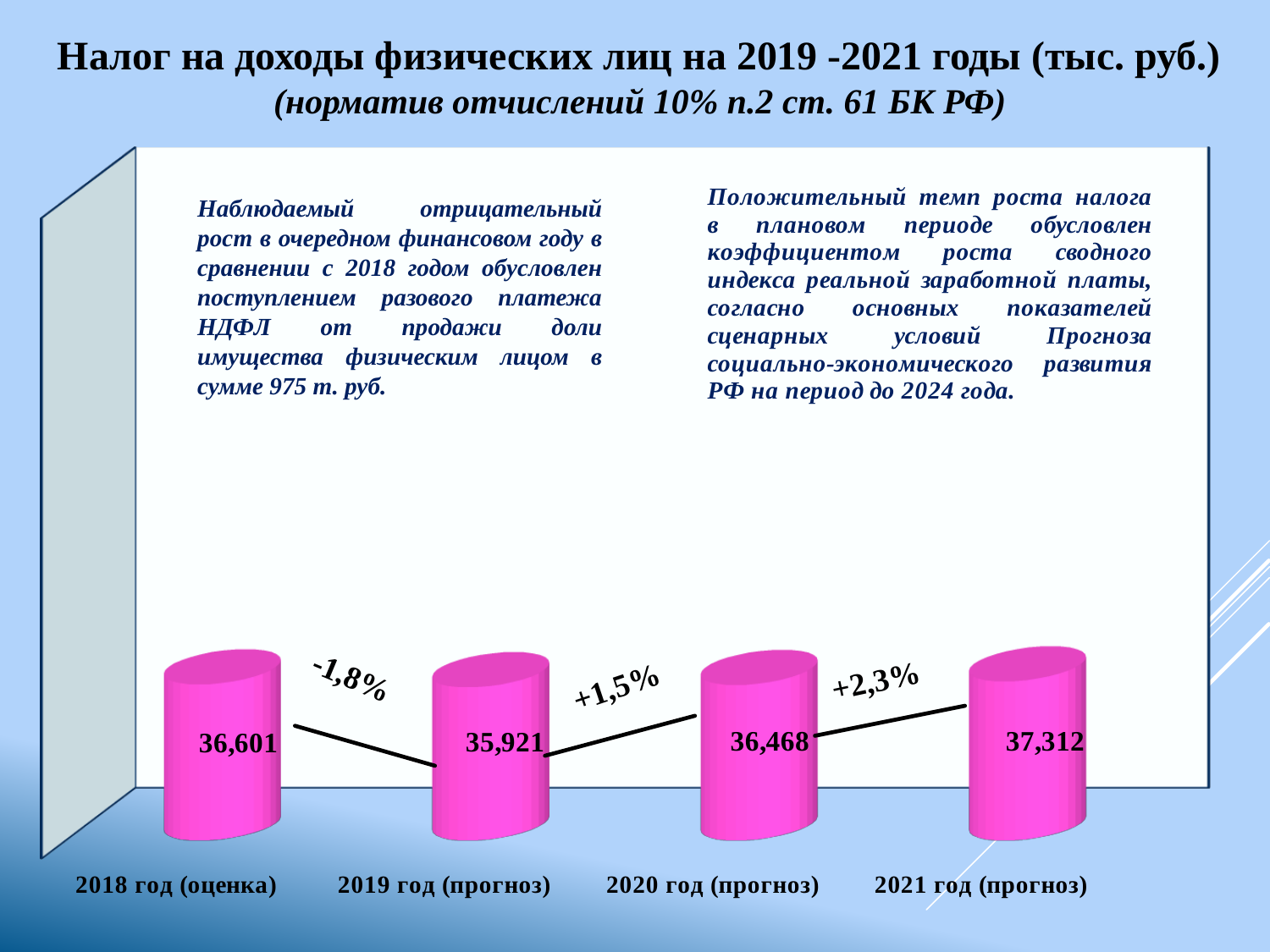
Which year has the lowest value? 2019 год (прогноз) Which is larger, the value for 2020 год (прогноз) or the value for 2018 год (оценка)? 2018 год (оценка) How many years are shown on the chart? 4 What is the value for 2018 год (оценка)? 36,601 What is the value for 2020 год (прогноз)? 36,468 What is the value for 2019 год (прогноз)? 35,921 What kind of chart is shown on the slide? Bar chart What is the value for 2021 год (прогноз)? 37,312 Which year has the highest value? 2021 год (прогноз) What percentage change is labelled between 2020 год (прогноз) and 2021 год (прогноз)? +2,3% What is the difference between the values for 2018 год (оценка) and 2019 год (прогноз)? 680 What is the difference between the values for 2021 год (прогноз) and 2020 год (прогноз)? 844